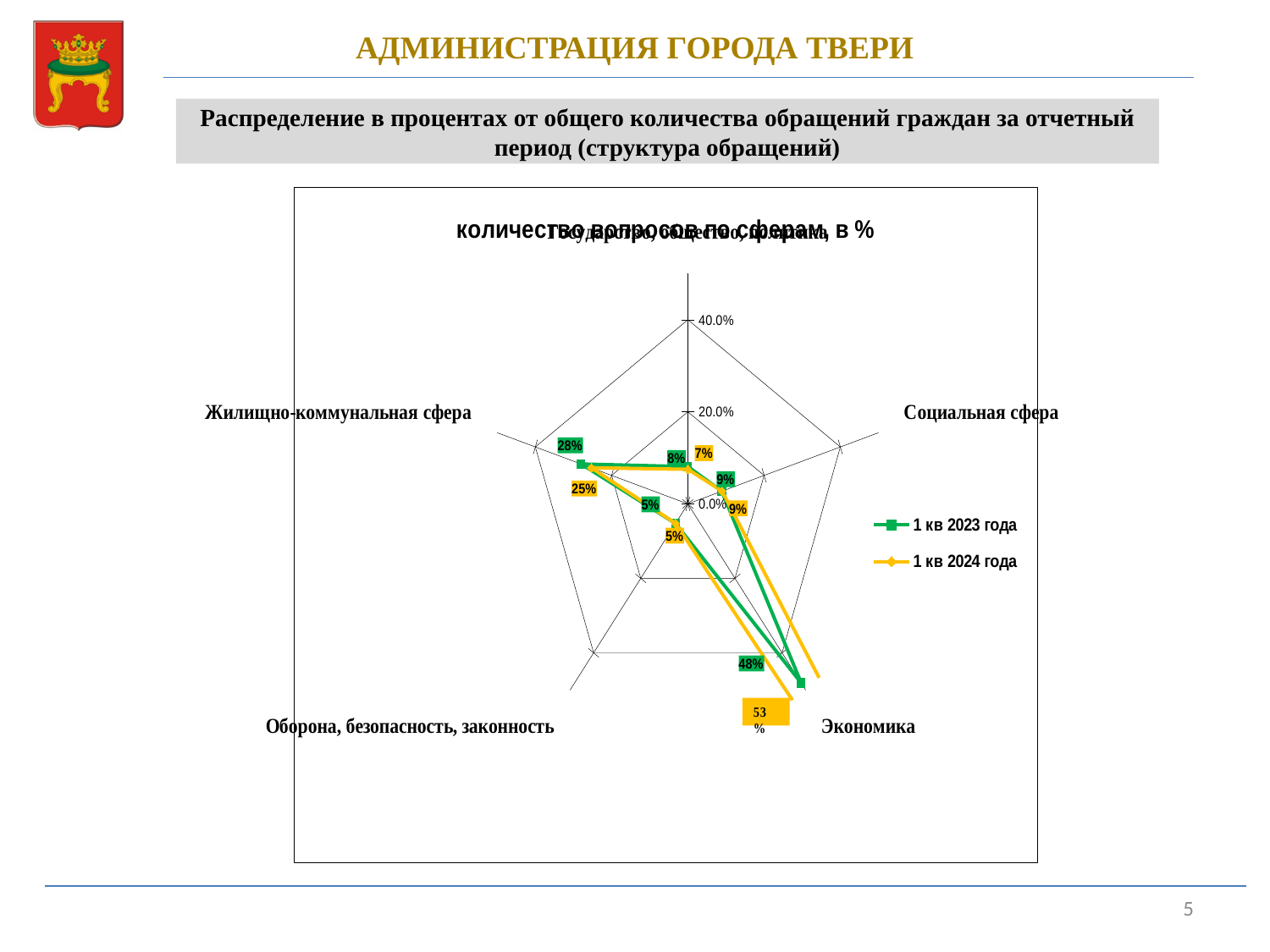
What is the difference between the 1 кв 2024 года and 1 кв 2023 года values for Экономика? 5% What is the value for Социальная сфера in the 1 кв 2024 года series? 9% What kind of chart is shown on the slide? Radar chart What is the value for Экономика in the 1 кв 2024 года series? 53% Which category has the highest value in the 1 кв 2024 года series? Экономика How many series does the chart legend list? 2 What is the value for Жилищно-коммунальная сфера in the 1 кв 2024 года series? 25% For Жилищно-коммунальная сфера, which series has the larger value, 1 кв 2023 года or 1 кв 2024 года? 1 кв 2023 года What is the value for Жилищно-коммунальная сфера in the 1 кв 2023 года series? 28% What is the value for Экономика in the 1 кв 2023 года series? 48% What is the value for Оборона, безопасность, законность in the 1 кв 2023 года series? 5% What is the title of the chart? количество вопросов по сферам, в %